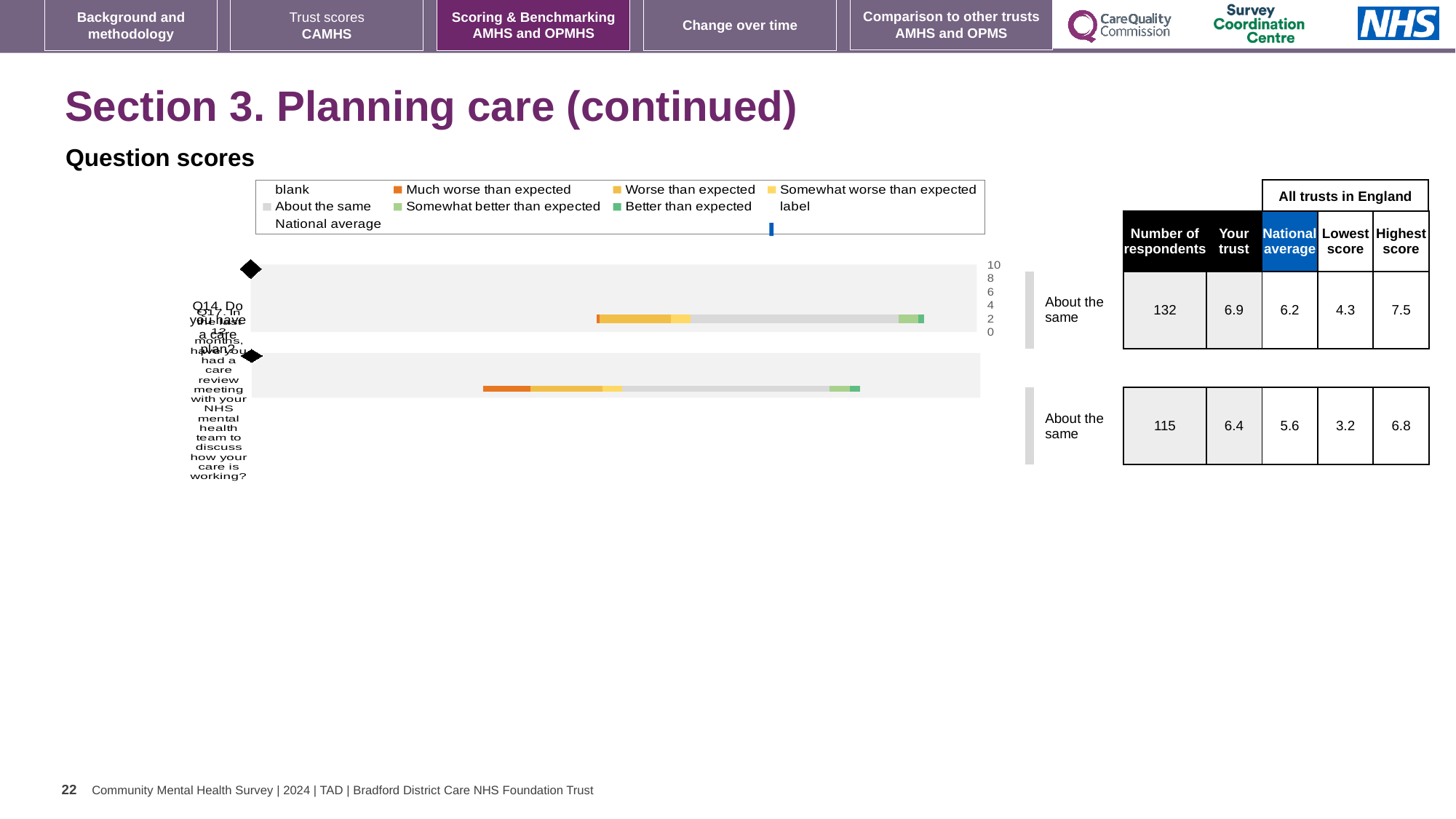
Which question has more respondents, Q14 or Q17? Q14 According to the table beside the chart, what is the national average for Q17 (care review meeting)? 5.6 In the chart legend, which category is shown in orange? Much worse than expected According to the table beside the chart, what is the 'Your trust' score for Q14 (Do you have a care plan?)? 6.9 What kind of chart is shown under 'Question scores'? bar chart How many questions (bars) are plotted in the chart? 2 How many respondents answered Q14 according to the table beside the chart? 132 What is the difference between the 'Your trust' score and the national average for Q14? 0.7 What is the maximum value shown on the chart's score axis? 10 What is the highest score among all trusts in England for Q17, as shown in the table beside the chart? 6.8 What benchmark category is shown next to the bar for Q17? About the same Which question has the higher 'Your trust' score, Q14 or Q17? Q14